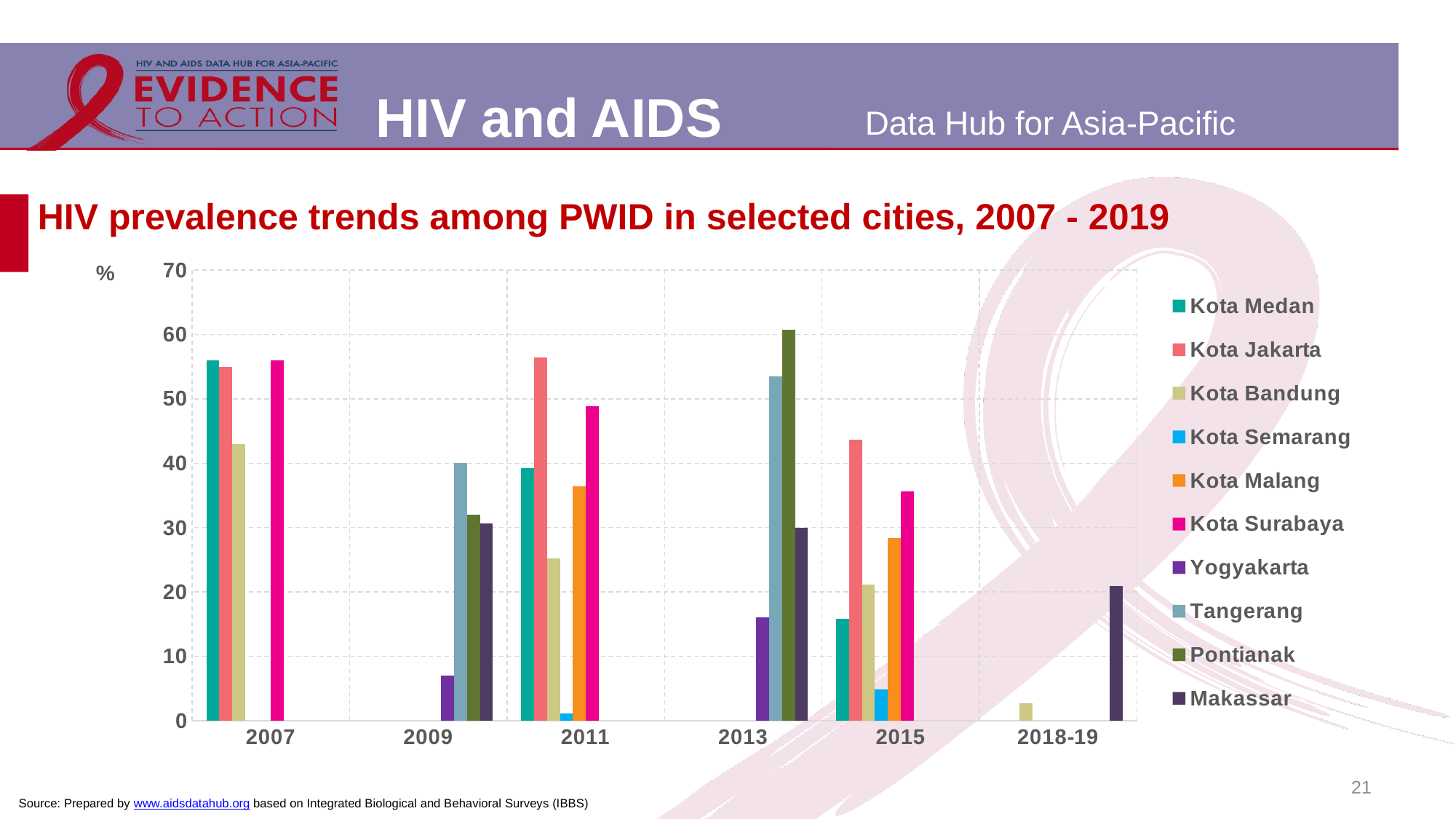
Does the value for Kota Medan rise or fall from 2007 to 2015? Fall Is the value for Kota Jakarta in 2011 greater or less than 50? greater How many year categories are shown on the x axis? 6 What is the title of the chart? HIV prevalence trends among PWID in selected cities, 2007 - 2019 Is the value for Makassar in 2018-19 greater or less than 30? less Is the value for Tangerang in 2009 greater or less than 30? greater How many series does the legend list? 10 In 2015, which is larger: the value for Kota Jakarta or the value for Kota Surabaya? Kota Jakarta Which city has the highest HIV prevalence in 2013? Pontianak Which city has the lowest HIV prevalence in 2011? Kota Semarang What kind of chart is shown on the slide? Bar chart